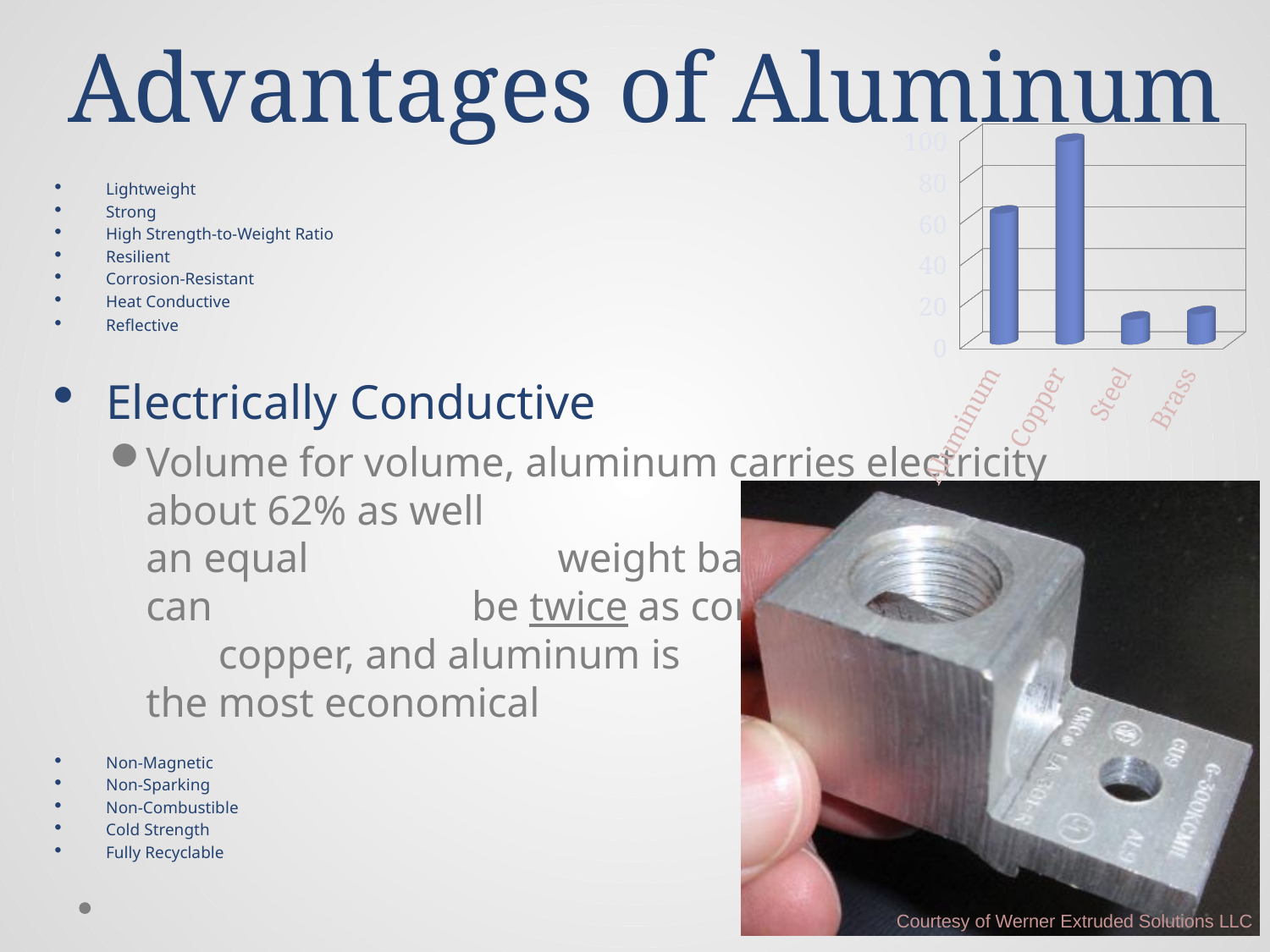
What is the highest value shown on the chart's vertical axis? 100 Which category has the highest bar in the chart? Copper What are the category labels along the horizontal axis of the chart? Aluminum, Copper, Steel, Brass Is the value for Steel greater or less than 20? less Which is larger in the chart, the value for Aluminum or the value for Steel? Aluminum Is the value for Aluminum greater or less than 80? less What kind of chart is shown on the slide? bar chart Which is larger in the chart, the value for Copper or the value for Aluminum? Copper Is the value for Aluminum greater or less than 40? greater How many categories are plotted in the bar chart? 4